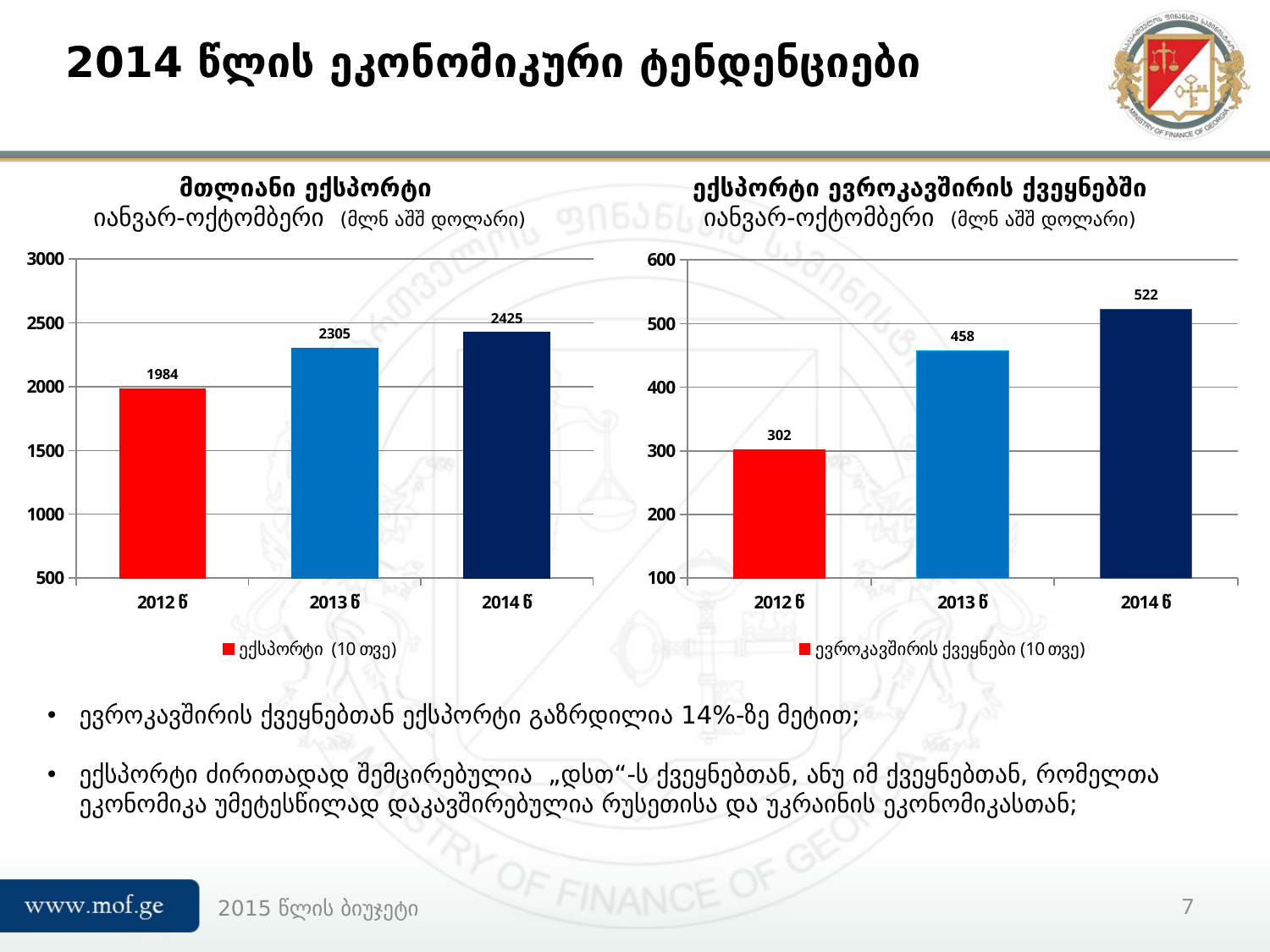
How many bars are shown in the right chart (ექსპორტი ევროკავშირის ქვეყნებში)? 3 In the left chart (მთლიანი ექსპორტი), what is the value for 2013 წ? 2305 In the right chart (ექსპორტი ევროკავშირის ქვეყნებში), which year has the lowest value? 2012 წ In the left chart (მთლიანი ექსპორტი), what is the difference between the 2014 წ and 2013 წ values? 120 In the left chart (მთლიანი ექსპორტი), do the values rise or fall from 2012 წ to 2014 წ? rise In the right chart (ექსპორტი ევროკავშირის ქვეყნებში), what is the value for 2014 წ? 522 In the right chart (ექსპორტი ევროკავშირის ქვეყნებში), what is the value for 2012 წ? 302 In the right chart (ექსპორტი ევროკავშირის ქვეყნებში), which is larger, the value for 2013 წ or 2014 წ? 2014 წ In the right chart (ექსპორტი ევროკავშირის ქვეყნებში), what is the difference between the 2013 წ and 2012 წ values? 156 What type of chart is the left chart (მთლიანი ექსპორტი)? bar chart In the left chart (მთლიანი ექსპორტი), which year has the highest value? 2014 წ In the left chart (მთლიანი ექსპორტი), what is the value for 2012 წ? 1984